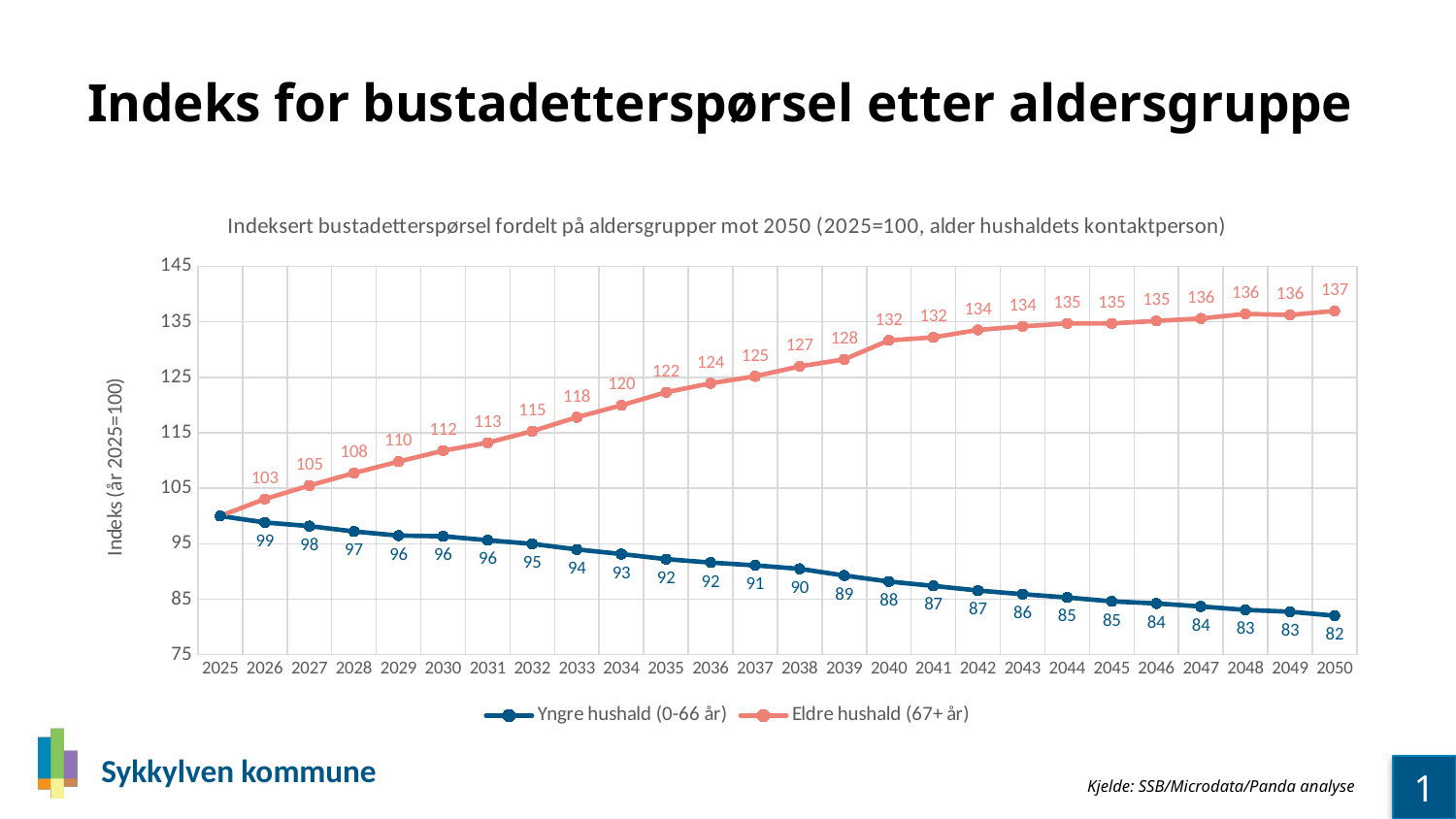
How many years are shown on the x axis? 26 What is the value for Yngre hushald (0-66 år) in 2032? 95 What is the value for Yngre hushald (0-66 år) in 2040? 88 In which year does Yngre hushald (0-66 år) reach its lowest value? 2050 Which series has the larger value in 2035, Eldre hushald (67+ år) or Yngre hushald (0-66 år)? Eldre hushald (67+ år) What is the value for Eldre hushald (67+ år) in 2033? 118 Does the value for Yngre hushald (0-66 år) rise or fall from 2025 to 2050? Fall In which year does Eldre hushald (67+ år) reach its highest value? 2050 What is the difference between Eldre hushald (67+ år) and Yngre hushald (0-66 år) in 2050? 55 What is the value for Eldre hushald (67+ år) in 2050? 137 How many series does the legend list? 2 What kind of chart is shown on the slide? Line chart